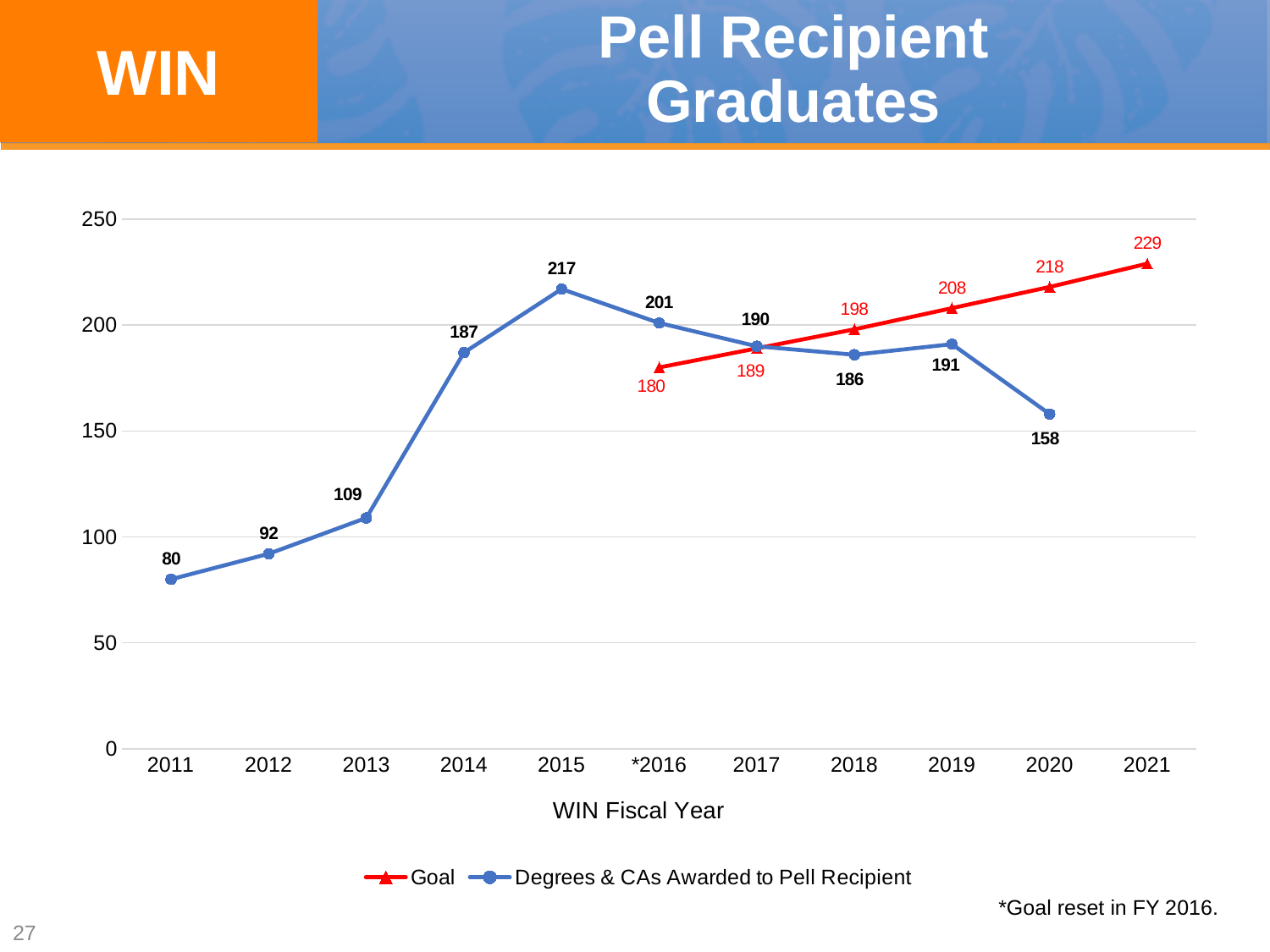
In which year is the Degrees & CAs Awarded to Pell Recipient series highest? 2015 How many series does the legend list? 2 What kind of chart is shown on the slide? Line chart Which is larger in 2018: the Goal or the Degrees & CAs Awarded to Pell Recipient? Goal In which year is the Degrees & CAs Awarded to Pell Recipient series lowest? 2011 How many fiscal years are shown on the x axis? 11 What is the Goal value for 2021? 229 What is the difference between the Goal and the Degrees & CAs Awarded to Pell Recipient in 2020? 60 What is the value of Degrees & CAs Awarded to Pell Recipient in 2020? 158 Does the Goal series rise or fall from *2016 to 2021? Rise What is the value of Degrees & CAs Awarded to Pell Recipient in 2015? 217 What is the x-axis title of the chart? WIN Fiscal Year